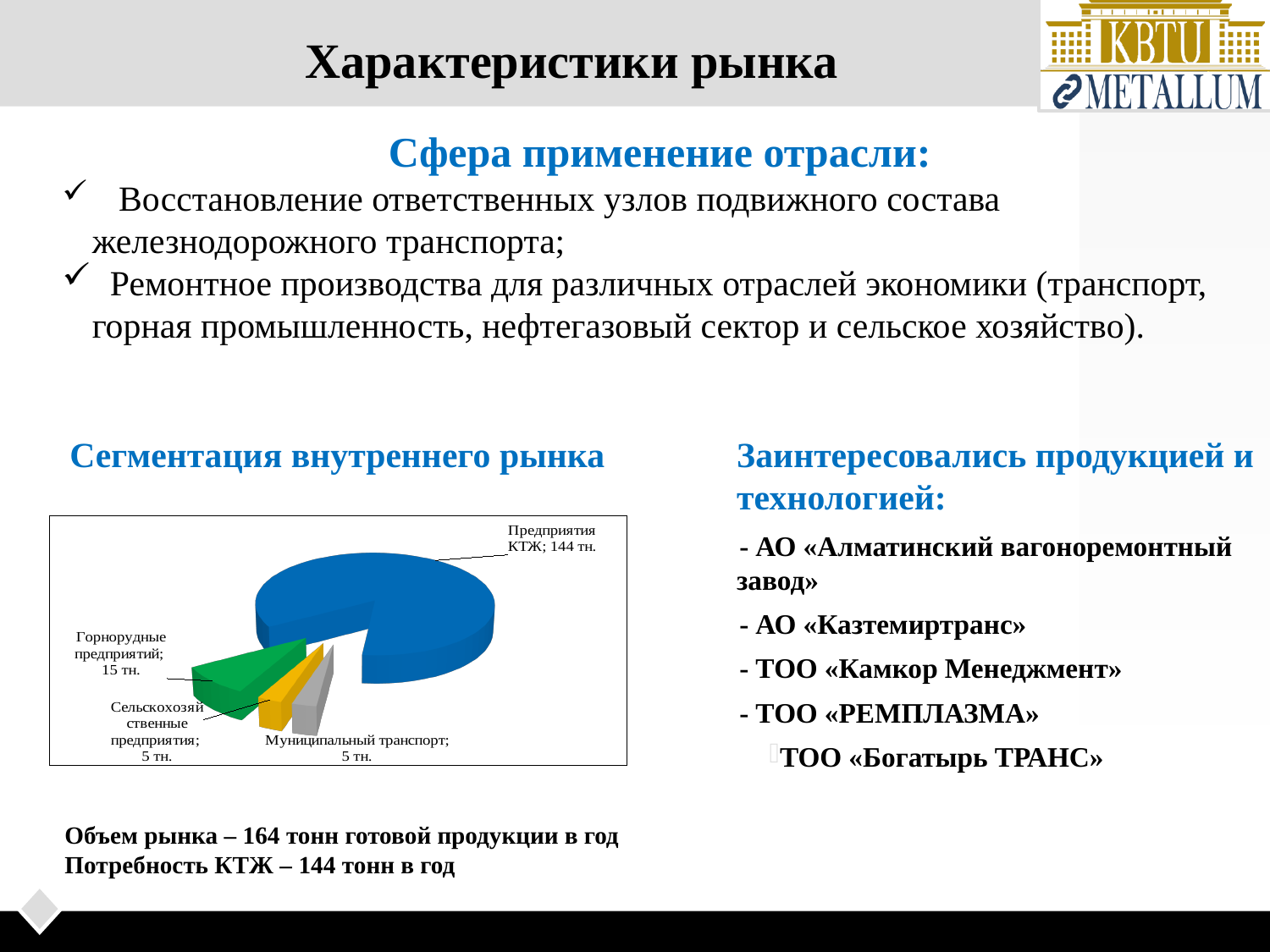
What is the value for Предприятия КТЖ in the pie chart? 144 тн. Which is larger in the pie chart: Горнорудные предприятий or Сельскохозяйственные предприятия? Горнорудные предприятий What is the heading above the pie chart? Сегментация внутреннего рынка What is the difference between the values for Горнорудные предприятий and Муниципальный транспорт in the pie chart? 10 тн. What colour is the slice for Предприятия КТЖ in the pie chart? blue How many slices does the pie chart have? 4 What is the value for Горнорудные предприятий in the pie chart? 15 тн. What is the value for Сельскохозяйственные предприятия in the pie chart? 5 тн. What is the difference between the values for Предприятия КТЖ and Горнорудные предприятий in the pie chart? 129 тн. Which category has the largest slice in the pie chart? Предприятия КТЖ What is the value for Муниципальный транспорт in the pie chart? 5 тн. What type of chart is shown under the heading "Сегментация внутреннего рынка"? pie chart